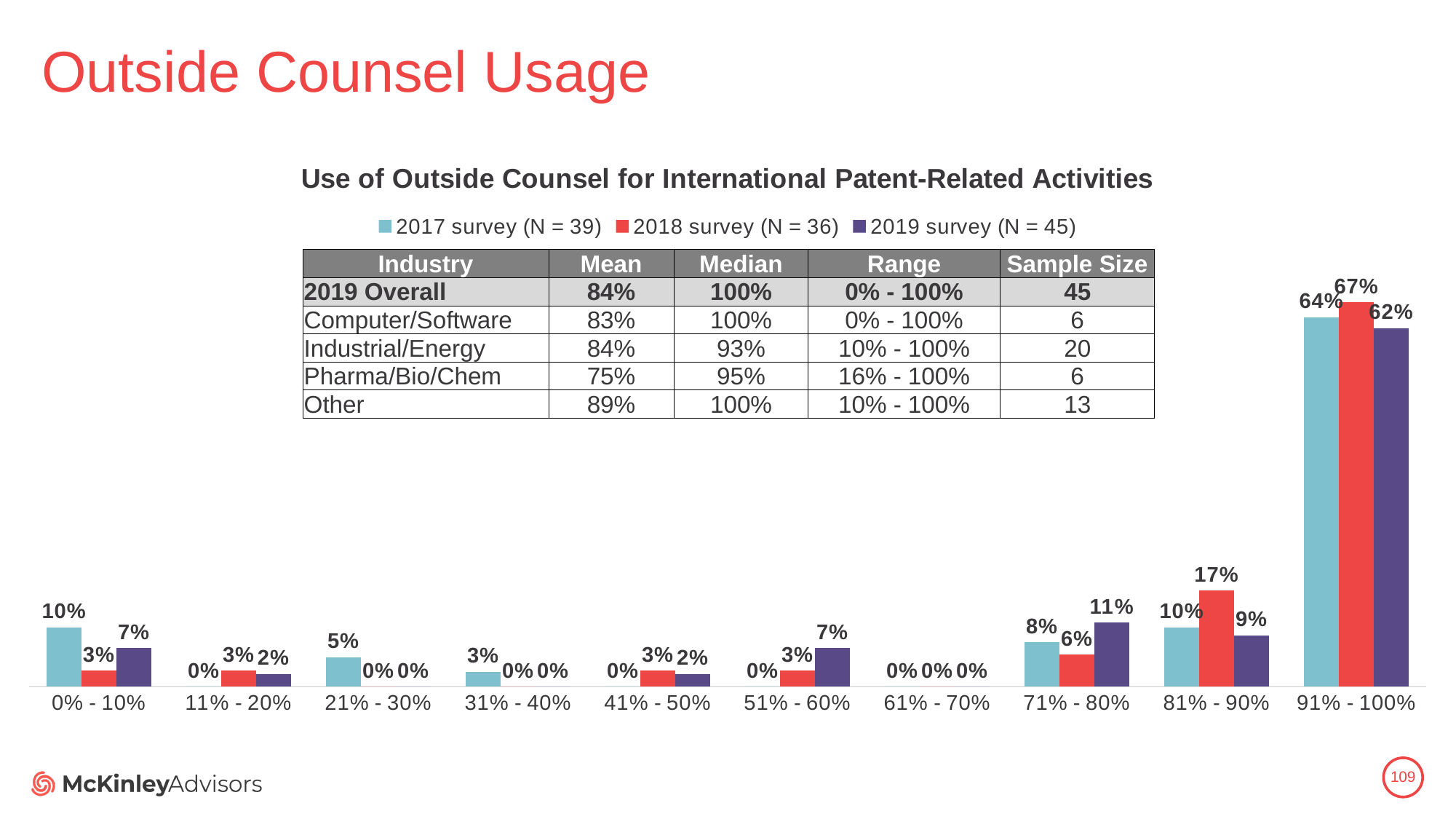
What is the value for the 2018 survey in the 21% - 30% category? 0% What is the value for the 2019 survey in the 71% - 80% category? 11% What is the value for the 2018 survey in the 91% - 100% category? 67% How many series does the chart legend list? 3 How many categories (ranges) are shown along the x axis of the chart? 10 What is the value for the 2017 survey in the 0% - 10% category? 10% What is the difference between the 2018 survey and the 2017 survey values in the 81% - 90% category? 7% What is the title of the chart? Use of Outside Counsel for International Patent-Related Activities What type of chart is shown on the slide? Bar chart What is the difference between the 2019 survey and the 2018 survey values in the 51% - 60% category? 4% In the 91% - 100% category, which is larger: the 2017 survey value or the 2019 survey value? 2017 survey Which category has the highest value for the 2019 survey? 91% - 100%